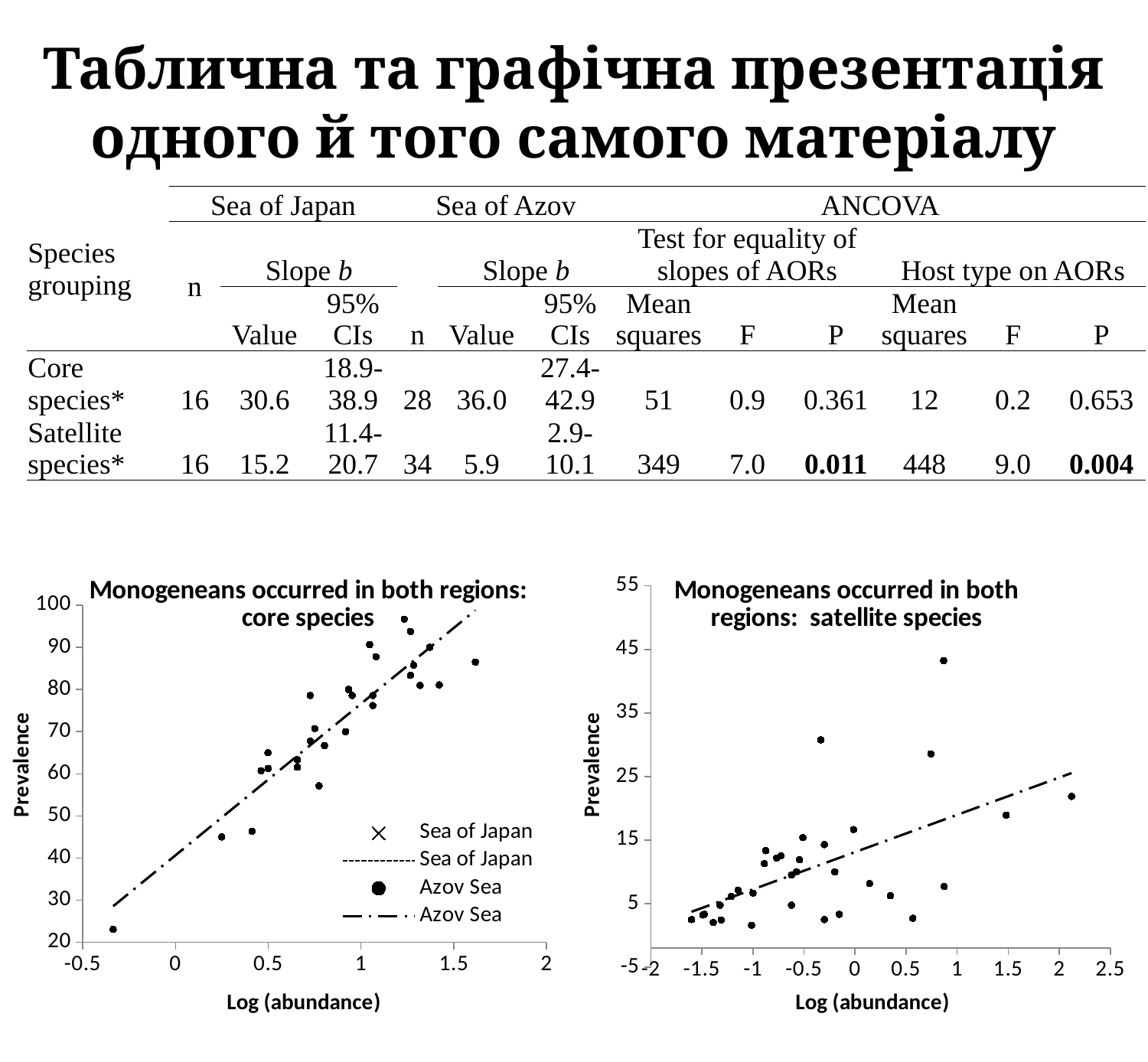
How many entries does the legend of the core species chart list? 4 Which chart has the higher maximum prevalence value plotted, the core species chart or the satellite species chart? core species chart Which two regions are named in the legend of the core species chart? Sea of Japan and Azov Sea What is the x-axis title of the core species chart? Log (abundance) In the core species chart, does prevalence rise or fall as log (abundance) increases? rise In the core species chart, is the prevalence of the highest point greater or less than 90? greater What kind of chart is the 'Monogeneans occurred in both regions: core species' chart? scatter chart In the core species chart, is the prevalence of the lowest point greater or less than 30? less In the satellite species chart, is the prevalence of the highest point greater or less than 35? greater What kind of chart is the 'Monogeneans occurred in both regions: satellite species' chart? scatter chart In the satellite species chart, does the fitted dash-dot line rise or fall as log (abundance) increases? rise